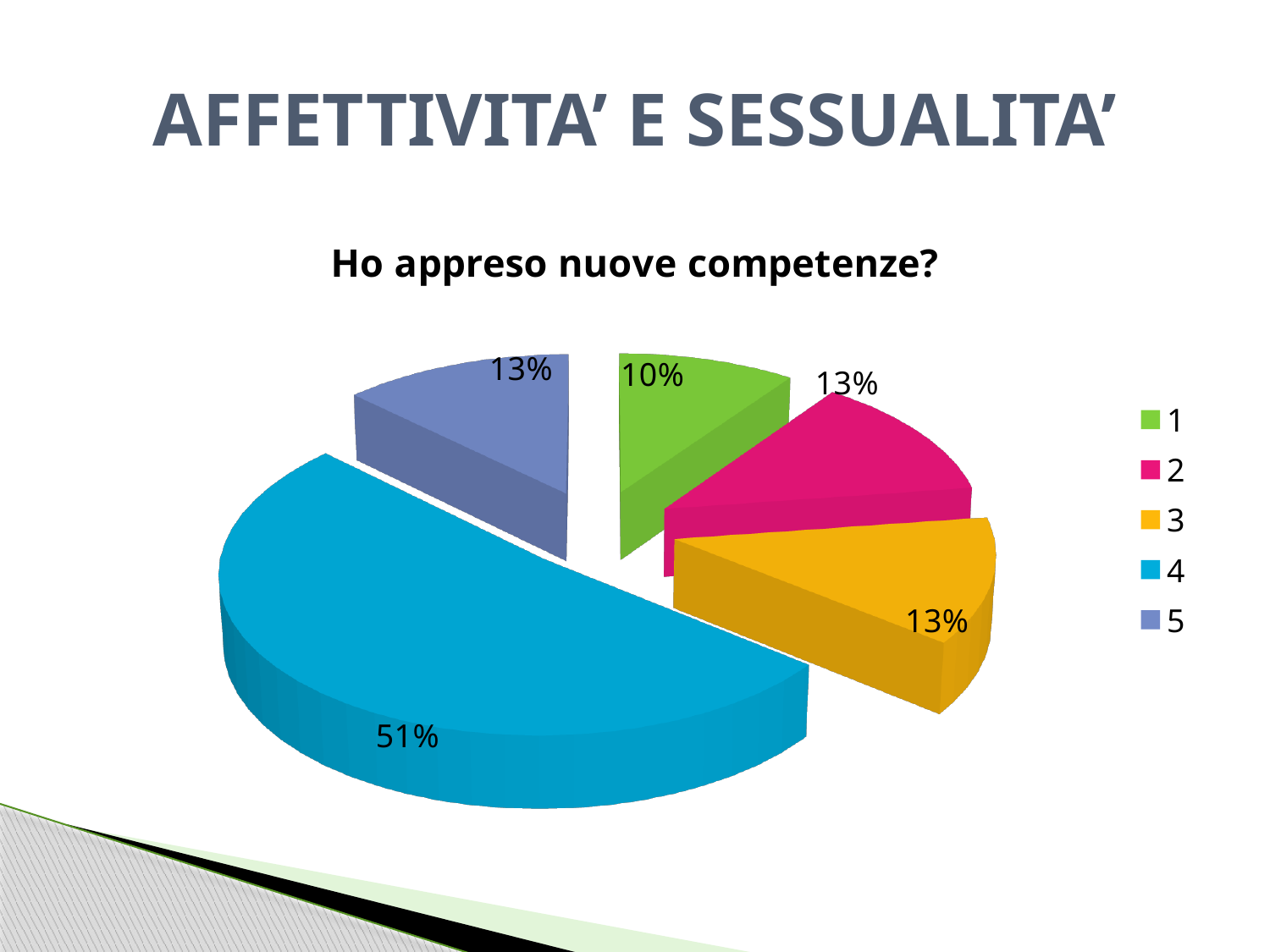
What share of the pie does category 4 represent? 51% What is the title of the chart? Ho appreso nuove competenze? What kind of chart is shown on the slide? pie chart What colour is the slice for category 4? blue Which category has the smallest slice of the pie? 1 What share of the pie does category 5 represent? 13% What share of the pie does category 2 represent? 13% Which category has the largest slice of the pie? 4 What is the difference in percentage points between category 4 and category 1? 41 How many categories does the legend list? 5 Which is larger, the slice for category 3 or the slice for category 1? 3